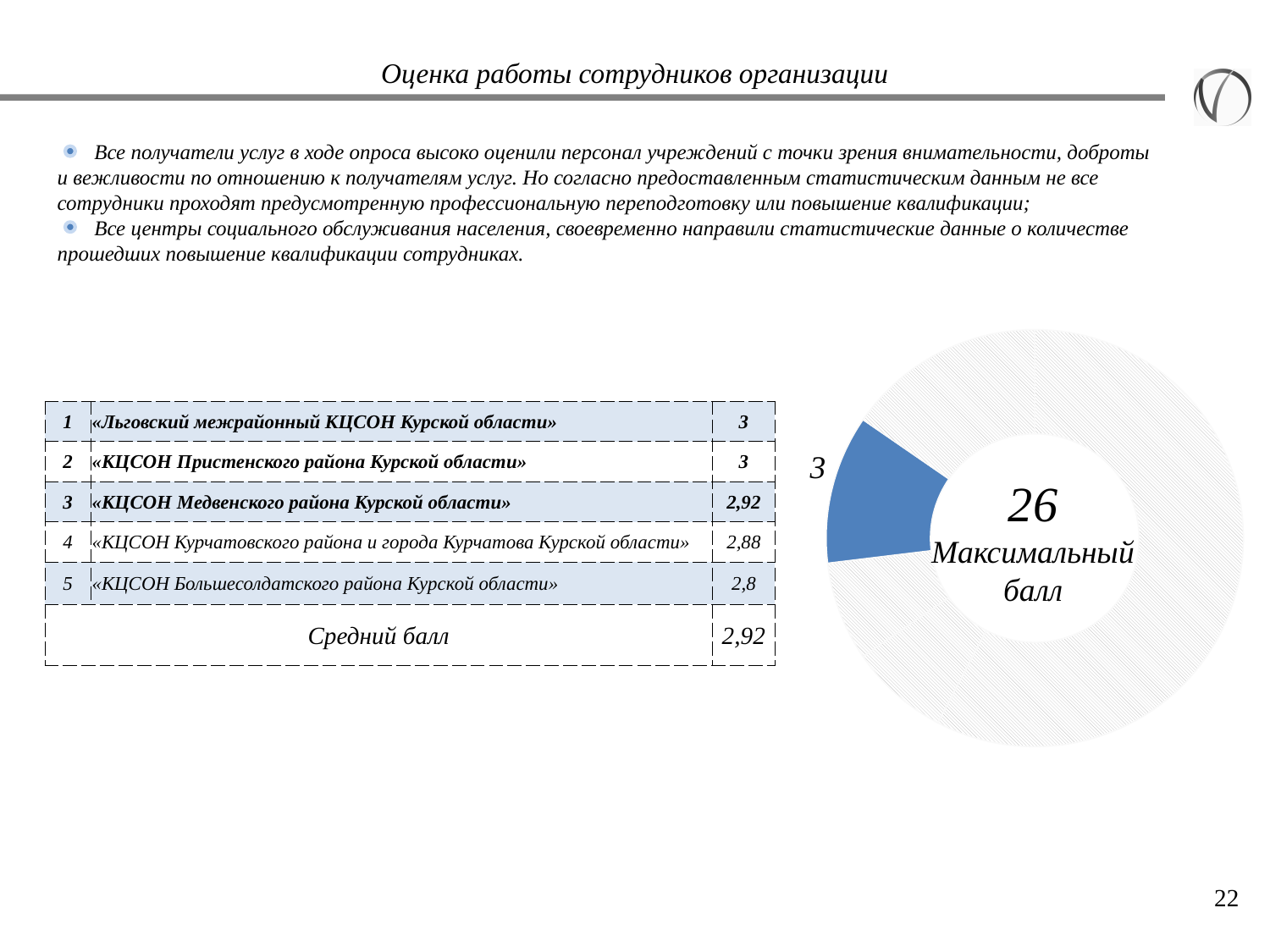
What text accompanies the number in the centre of the doughnut chart? Максимальный балл What number is printed in the centre of the doughnut chart? 26 Which segment of the doughnut chart is larger, the blue slice or the hatched segment? the hatched segment What value is labelled on the blue slice of the doughnut chart? 3 What kind of chart is shown on the right side of the slide? doughnut chart